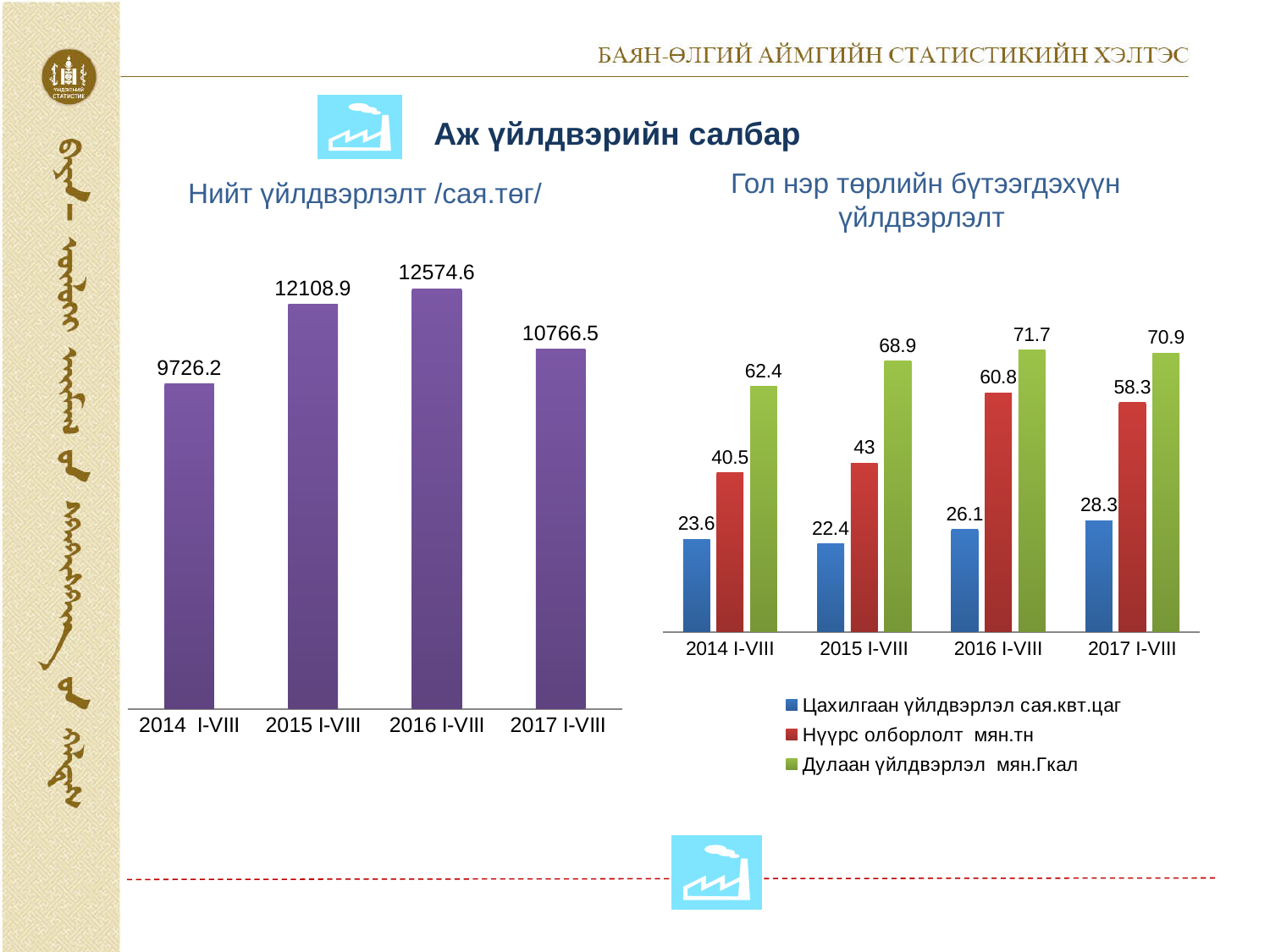
In the left chart 'Нийт үйлдвэрлэлт /сая.төг/', what is the difference between the 2015 I-VIII and 2017 I-VIII values? 1342.4 In the right chart 'Гол нэр төрлийн бүтээгдэхүүн үйлдвэрлэлт', which is larger for 2017 I-VIII: 'Нүүрс олборлолт мян.тн' or 'Дулаан үйлдвэрлэл мян.Гкал'? Дулаан үйлдвэрлэл мян.Гкал What type of chart is the left chart 'Нийт үйлдвэрлэлт /сая.төг/'? Bar chart In the right chart 'Гол нэр төрлийн бүтээгдэхүүн үйлдвэрлэлт', how many series does the legend list? 3 In the left chart 'Нийт үйлдвэрлэлт /сая.төг/', which period has the lowest value? 2014 I-VIII In the right chart 'Гол нэр төрлийн бүтээгдэхүүн үйлдвэрлэлт', what is the value of 'Нүүрс олборлолт мян.тн' for 2016 I-VIII? 60.8 In the right chart 'Гол нэр төрлийн бүтээгдэхүүн үйлдвэрлэлт', which period has the highest value for 'Дулаан үйлдвэрлэл мян.Гкал'? 2016 I-VIII In the right chart 'Гол нэр төрлийн бүтээгдэхүүн үйлдвэрлэлт', what is the value of 'Цахилгаан үйлдвэрлэл сая.квт.цаг' for 2015 I-VIII? 22.4 In the right chart 'Гол нэр төрлийн бүтээгдэхүүн үйлдвэрлэлт', what colour are the bars for 'Цахилгаан үйлдвэрлэл сая.квт.цаг'? Blue In the left chart 'Нийт үйлдвэрлэлт /сая.төг/', how many periods are shown on the x axis? 4 In the left chart 'Нийт үйлдвэрлэлт /сая.төг/', what is the value for 2016 I-VIII? 12574.6 In the left chart 'Нийт үйлдвэрлэлт /сая.төг/', which period has the highest value? 2016 I-VIII